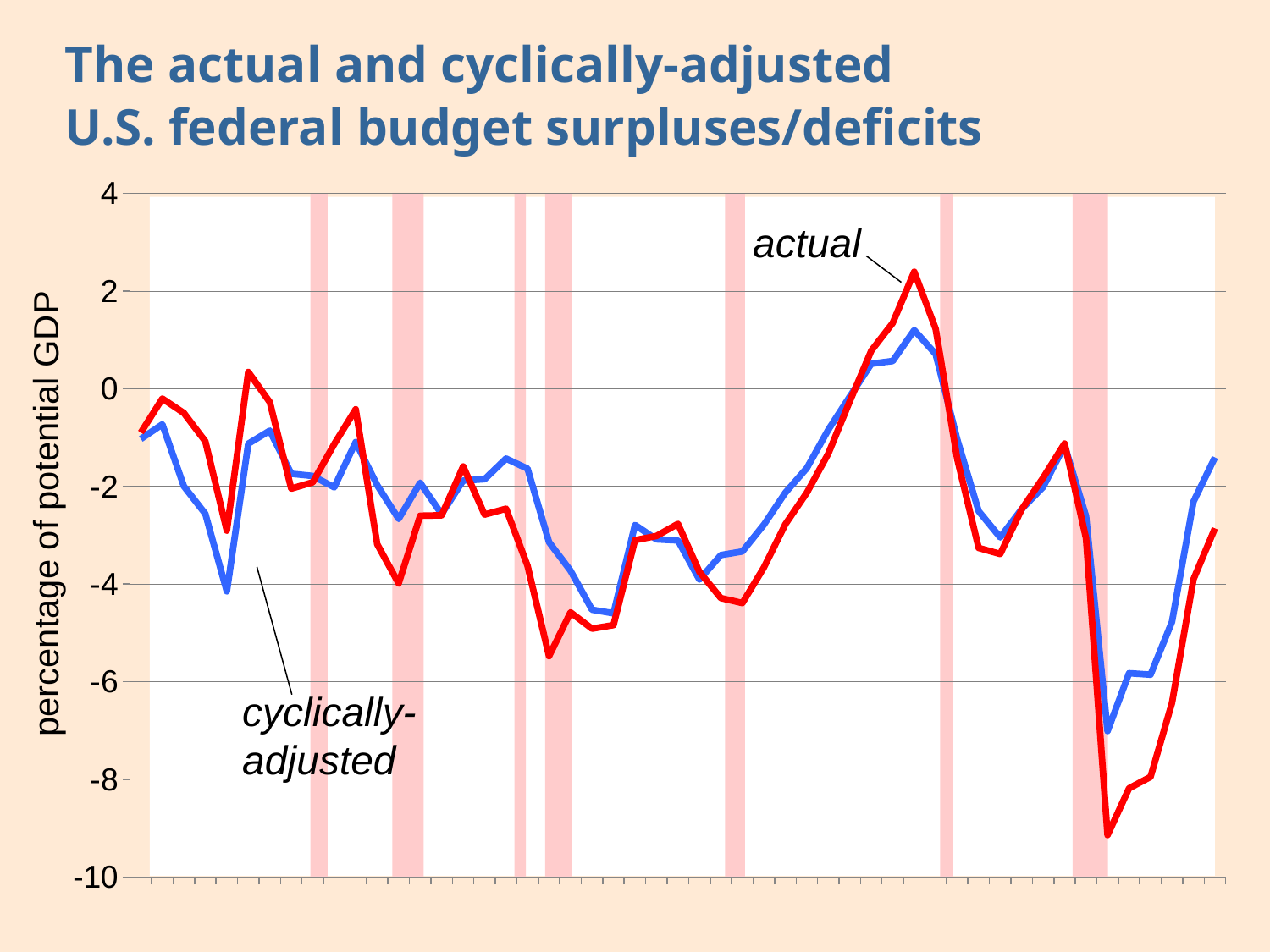
Which series reaches the lower minimum value, actual or cyclically-adjusted? actual What is the title of the chart on the slide? The actual and cyclically-adjusted U.S. federal budget surpluses/deficits Which series reaches the higher peak value, actual or cyclically-adjusted? actual How many data series are plotted on the chart? 2 Is the lowest value reached by the cyclically-adjusted series greater or less than -6? less Is the lowest value reached by the actual series greater or less than -8? less Is the highest value reached by the actual series greater or less than 2? greater What is the label on the vertical axis of the chart? percentage of potential GDP What kind of chart is shown on the slide? line chart At the far right end of the chart, are both lines rising or falling? rising